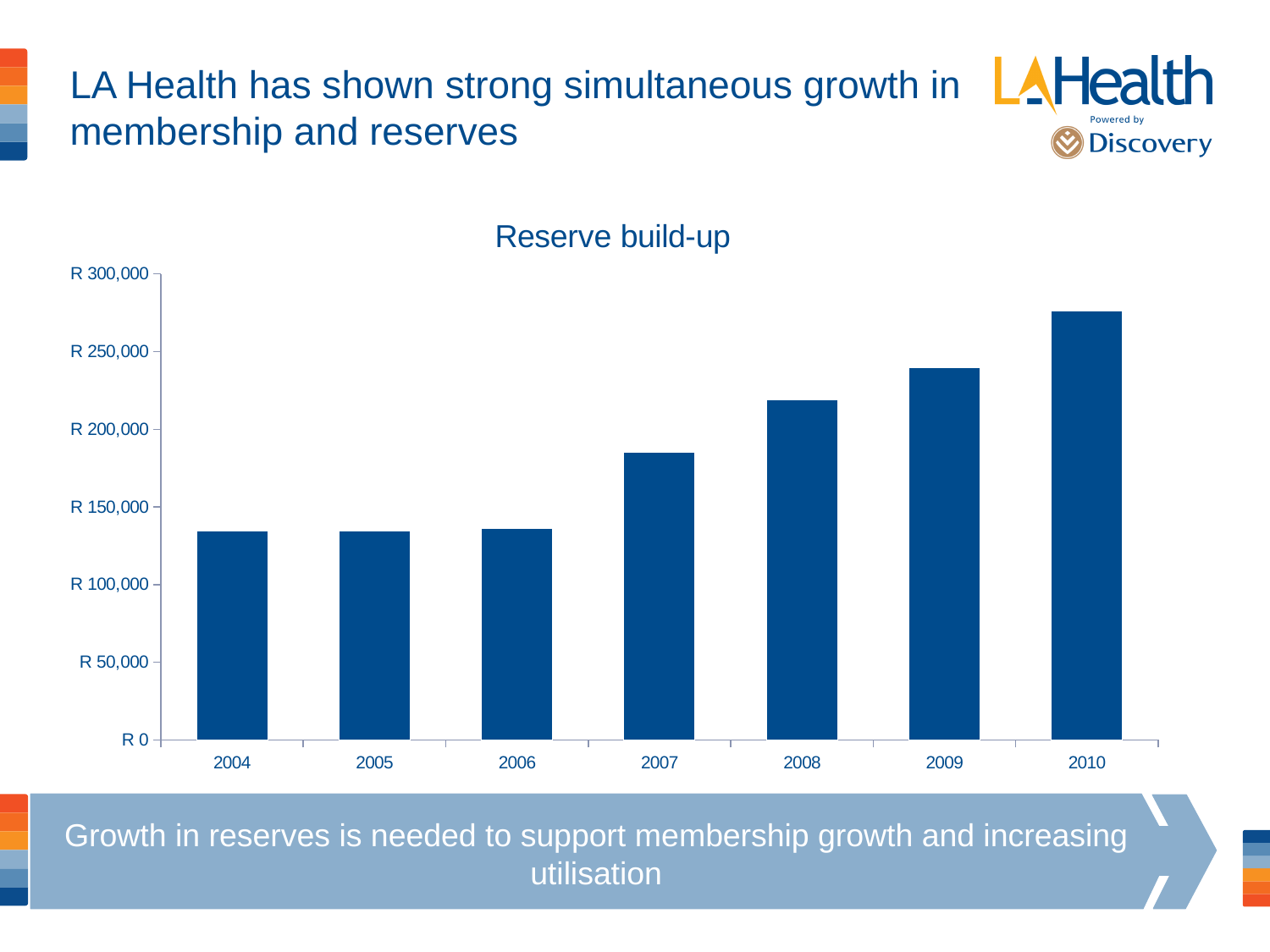
What kind of chart is shown on the slide? bar chart What is the title of the chart? Reserve build-up Which is larger, the value for 2006 or the value for 2008? 2008 Which is larger, the value for 2007 or the value for 2009? 2009 Do the reserve values generally rise or fall from 2004 to 2010? rise Is the value for 2008 greater or less than R 200,000? greater Is the value for 2007 greater or less than R 150,000? greater Is the value for 2010 greater or less than R 250,000? greater How many years are shown on the x axis of the chart? 7 Which year has the highest reserve value? 2010